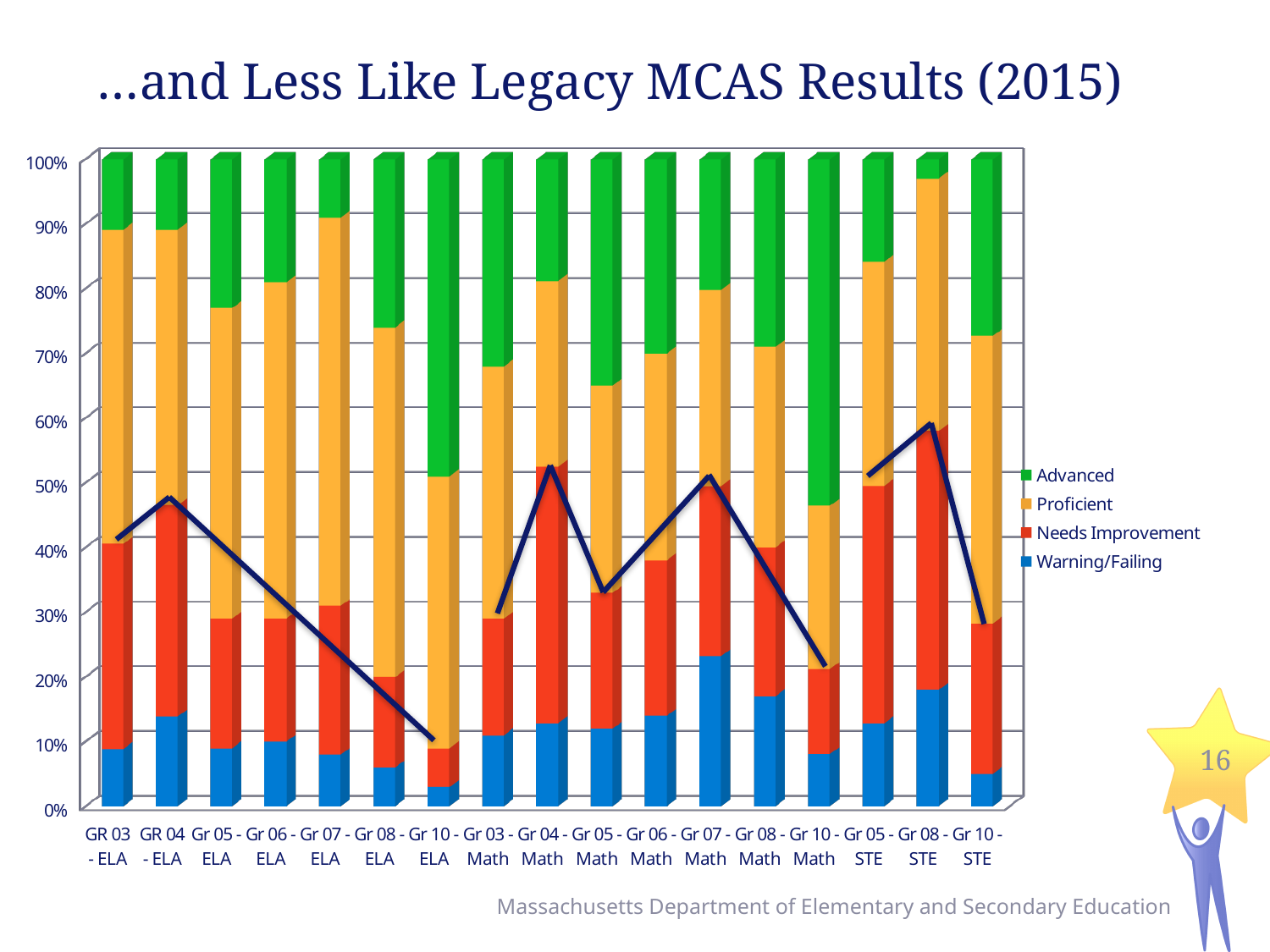
Is the Warning/Failing value for Gr 07 - Math greater or less than 20%? greater Which category has the smallest Warning/Failing segment? Gr 10 - ELA What is the title of the slide containing the chart? ...and Less Like Legacy MCAS Results (2015) Is the Advanced value for Gr 10 - ELA greater or less than 40%? greater What are the four series listed in the chart's legend? Advanced, Proficient, Needs Improvement, Warning/Failing How many categories are shown along the x axis of the chart? 17 Which category has the largest Warning/Failing segment? Gr 07 - Math Which has the larger Warning/Failing segment, Gr 08 - Math or GR 03 - ELA? Gr 08 - Math What kind of chart is shown on the slide? Stacked bar chart Which category has the smallest Advanced segment? Gr 08 - STE How many series does the chart's legend list? 4 What is the total of the stacked bar for GR 03 - ELA? 100%